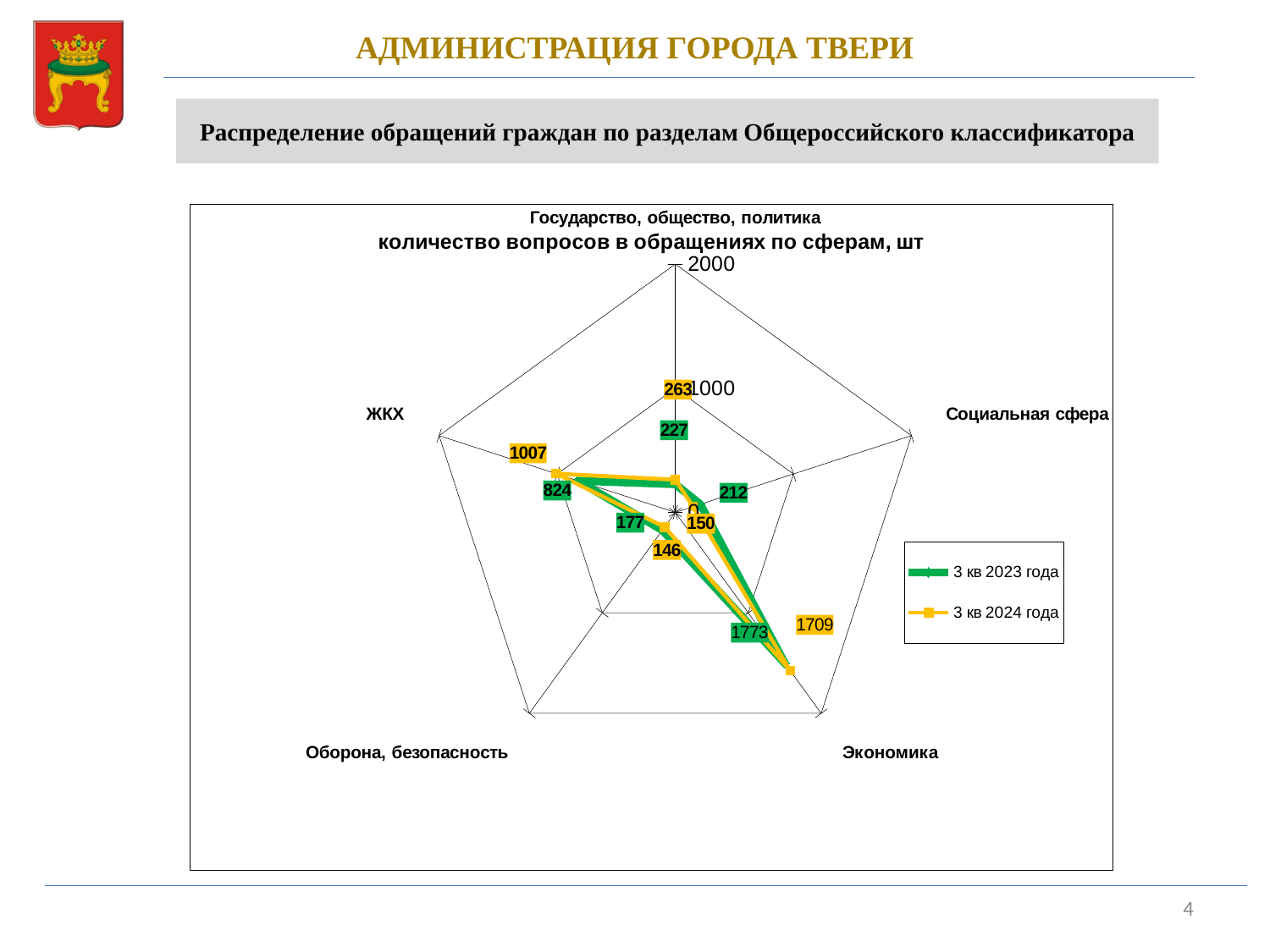
What is the value for Оборона, безопасность in the 3 кв 2024 года series? 146 Which is larger for Социальная сфера: the 3 кв 2023 года value or the 3 кв 2024 года value? 3 кв 2023 года How many series does the legend list? 2 What is the title of the chart? количество вопросов в обращениях по сферам, шт What is the value for Экономика in the 3 кв 2023 года series? 1773 Which category has the highest value in the 3 кв 2024 года series? Экономика What is the value for ЖКХ in the 3 кв 2024 года series? 1007 What is the difference between the ЖКХ values for 3 кв 2024 года and 3 кв 2023 года? 183 How many categories (axes) does the radar chart have? 5 What kind of chart is shown on the slide? radar chart Which category has the lowest value in the 3 кв 2023 года series? Оборона, безопасность What is the value for Государство, общество, политика in the 3 кв 2023 года series? 227